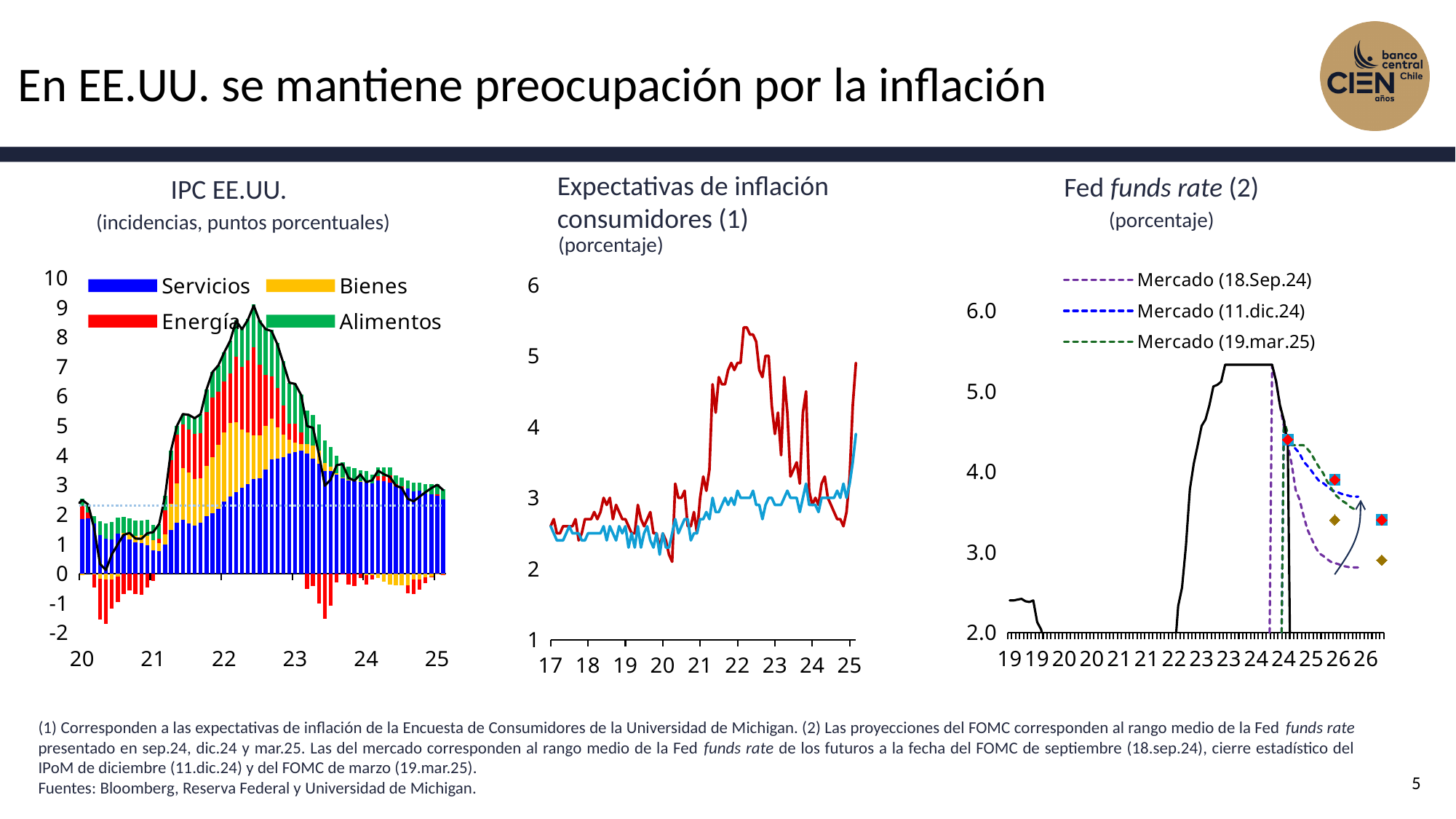
What kind of chart is the 'Expectativas de inflación consumidores (1)' chart in the middle? line chart In the 'IPC EE.UU.' chart, is the Energía contribution in 2020 greater or less than 0? less In the 'Fed funds rate (2)' chart, which legend entry corresponds to the market path dated 19.mar.25? Mercado (19.mar.25) What kind of chart is the 'IPC EE.UU.' chart on the left? bar chart How many entries does the legend of the 'Fed funds rate (2)' chart list? 3 In the 'Expectativas de inflación consumidores (1)' chart, is the peak of the red line in 2022 greater or less than 5? greater In the 'IPC EE.UU.' chart, is the lowest value of the black total line in 2020 greater or less than 1? less How many series does the legend of the 'IPC EE.UU.' chart list? 4 In the 'IPC EE.UU.' chart, which series is shown in blue? Servicios